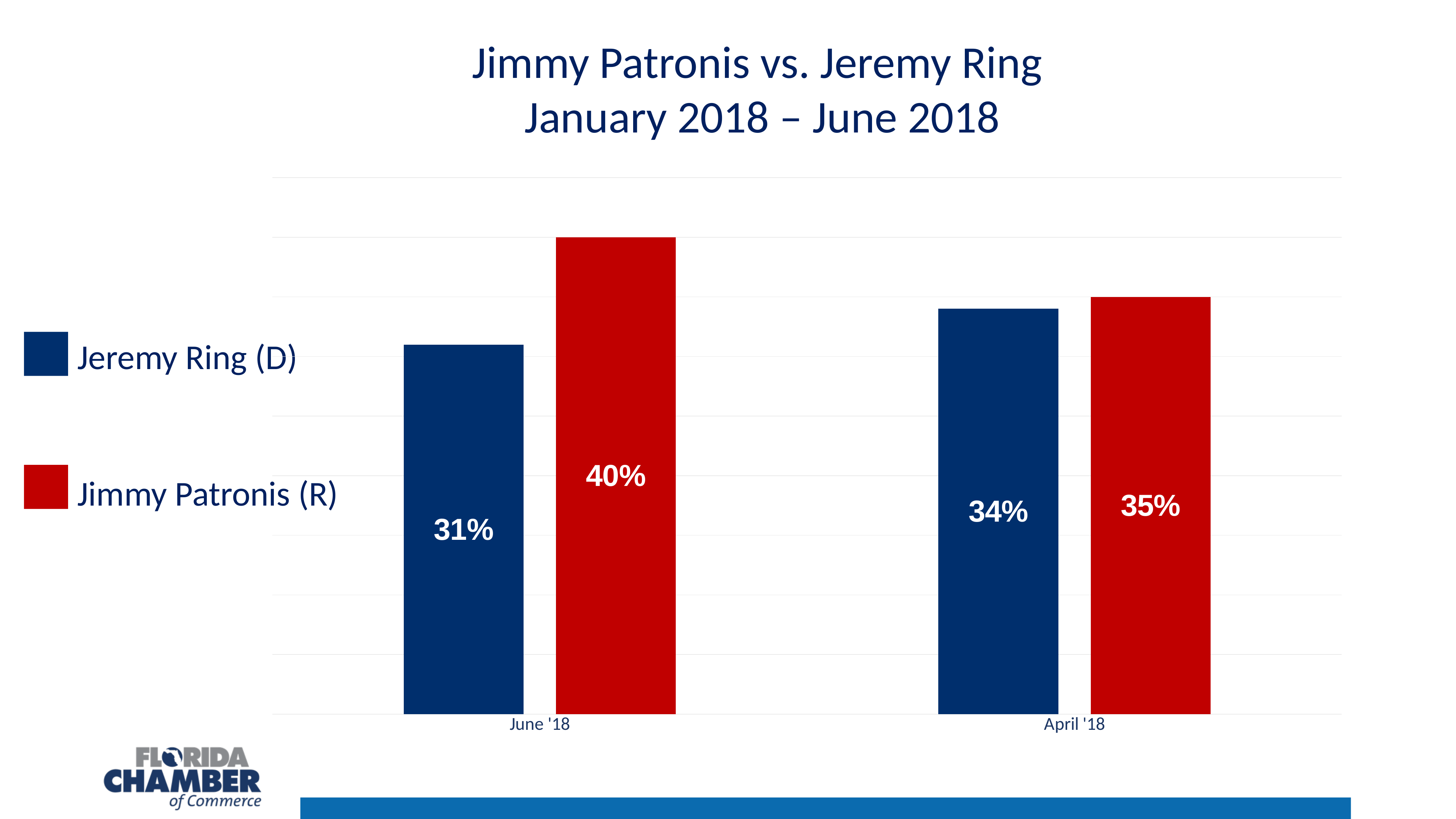
What kind of chart is shown on the slide? Bar chart What is the value for Jimmy Patronis (R) in April '18? 35% What is the difference between Jimmy Patronis (R) and Jeremy Ring (D) in June '18? 9% Which is larger in June '18: Jeremy Ring (D) or Jimmy Patronis (R)? Jimmy Patronis (R) What is the value for Jeremy Ring (D) in June '18? 31% How many series does the legend list? 2 What colour represents Jimmy Patronis (R) in the legend? Red What is the value for Jeremy Ring (D) in April '18? 34% Which bar has the lowest value on the chart? Jeremy Ring (D) in June '18 Which bar has the highest value on the chart? Jimmy Patronis (R) in June '18 What is the difference between Jimmy Patronis (R) and Jeremy Ring (D) in April '18? 1% What is the value for Jimmy Patronis (R) in June '18? 40%